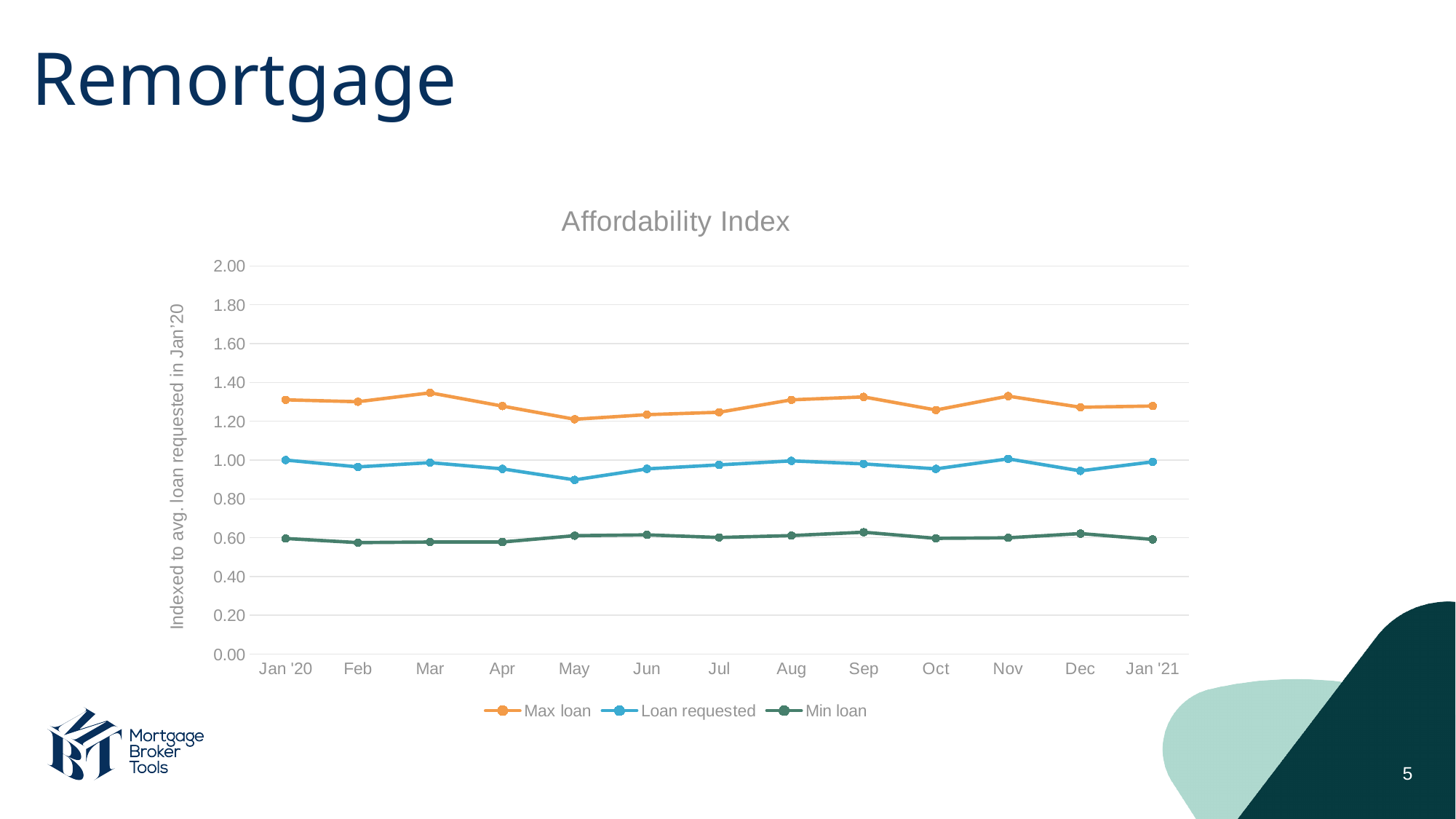
What is the label on the vertical axis of the chart? Indexed to avg. loan requested in Jan'20 What kind of chart is shown on the slide? line chart What is the title of the chart? Affordability Index Is the Loan requested value for May greater or less than 1.00? less Which series has the larger value in Sep, Max loan or Min loan? Max loan How many months are plotted along the x axis of the Affordability Index chart? 13 How many series does the legend of the Affordability Index chart list? 3 Does the Max loan series rise or fall from Mar to May? fall In which month is the Loan requested series at its lowest? May Is the Max loan value for Mar greater or less than 1.20? greater Is the Min loan value for Jan '20 greater or less than 0.80? less In which month is the Max loan series at its lowest? May